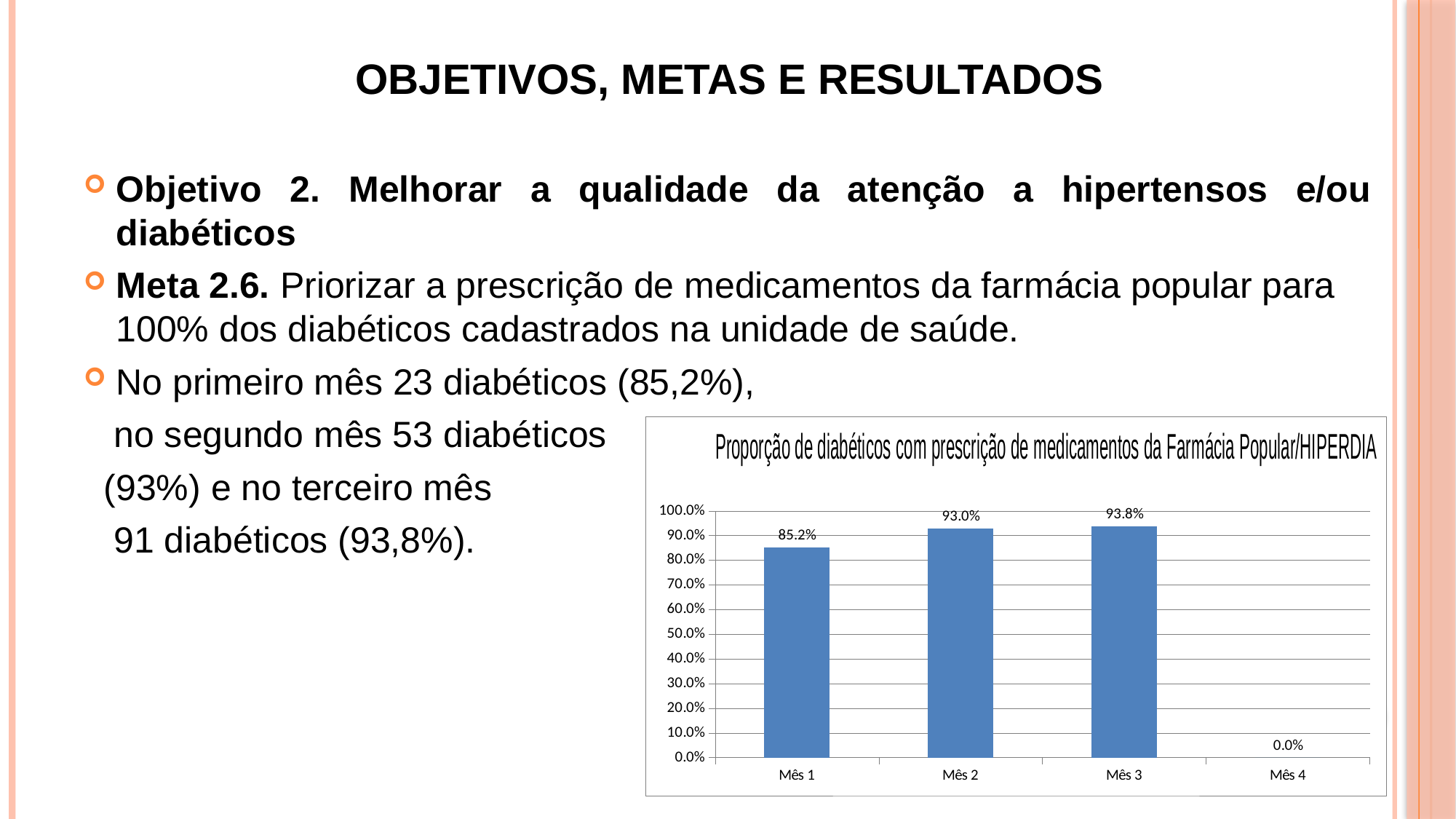
What is the title of the chart? Proporção de diabéticos com prescrição de medicamentos da Farmácia Popular/HIPERDIA What is the value for Mês 1? 85.2% What is the value for Mês 2? 93.0% What is the value for Mês 3? 93.8% Which is larger, the value for Mês 1 or the value for Mês 2? Mês 2 Which month has the highest value? Mês 3 What kind of chart is shown on the slide? Bar chart What is the difference between the values for Mês 2 and Mês 1? 7.8% Which month has the lowest value? Mês 4 How many months are shown on the x axis? 4 What is the difference between the values for Mês 3 and Mês 1? 8.6% What is the value for Mês 4? 0.0%